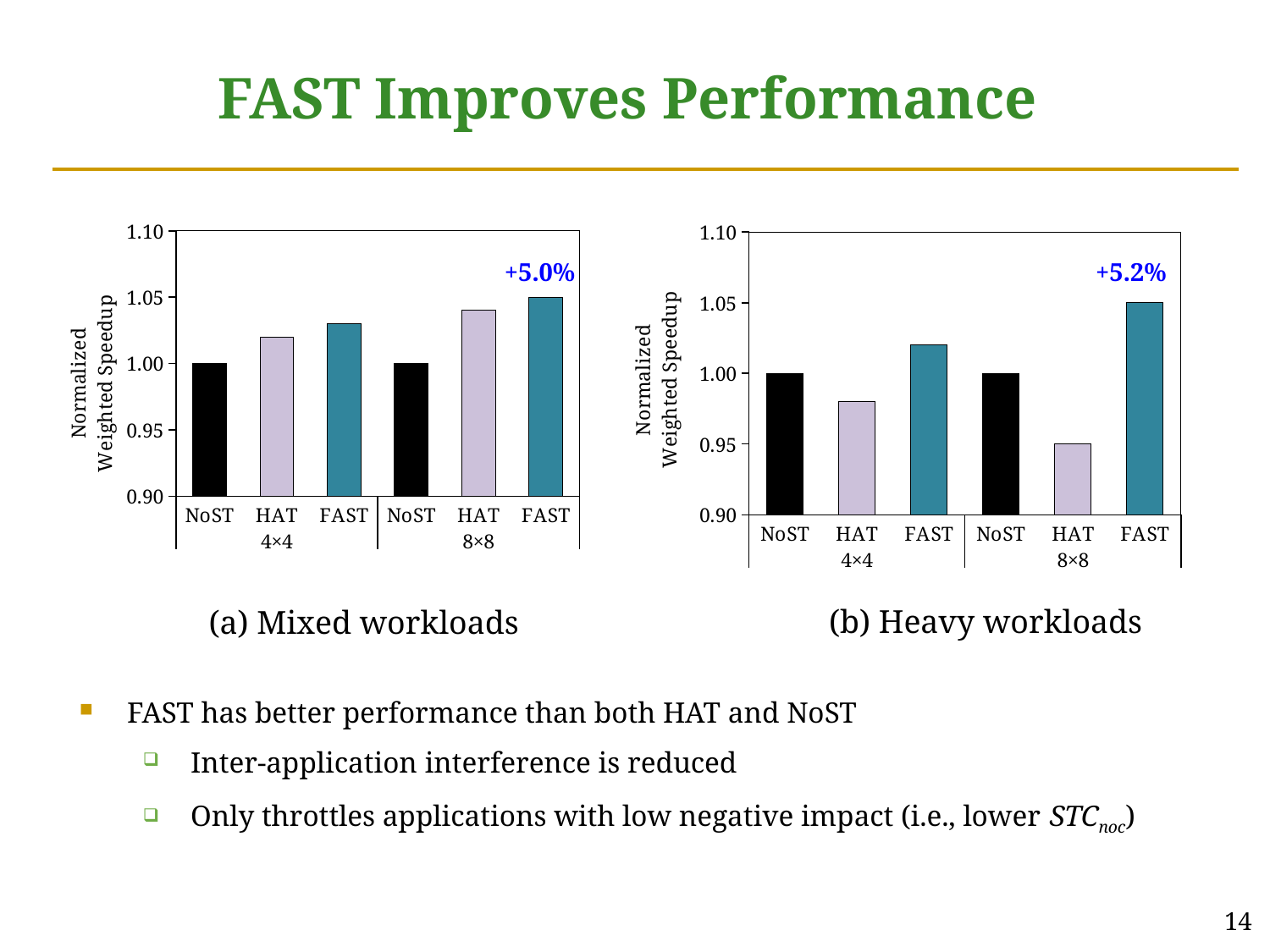
In the (a) Mixed workloads chart, is the value for HAT in the 4×4 group greater or less than 1.00? greater In the (a) Mixed workloads chart, which bar is the highest? FAST 8×8 In the (a) Mixed workloads chart, what is the normalized weighted speedup for NoST in the 4×4 group? 1.00 In the (b) Heavy workloads chart, what is the normalized weighted speedup for HAT in the 8×8 group? 0.95 In the (b) Heavy workloads chart, is the value for HAT in the 4×4 group greater or less than 1.00? less What type of chart is shown in (a) Mixed workloads? bar chart In the (b) Heavy workloads chart, what is the normalized weighted speedup for NoST in the 8×8 group? 1.00 In the (a) Mixed workloads chart, what percentage improvement is annotated above the FAST 8×8 bar? +5.0% In the (b) Heavy workloads chart, what percentage improvement is annotated above the FAST 8×8 bar? +5.2% In the (b) Heavy workloads chart, which bar is the lowest? HAT 8×8 How many bars are plotted in the (a) Mixed workloads chart? 6 In the (b) Heavy workloads chart, which is larger in the 4×4 group: HAT or FAST? FAST